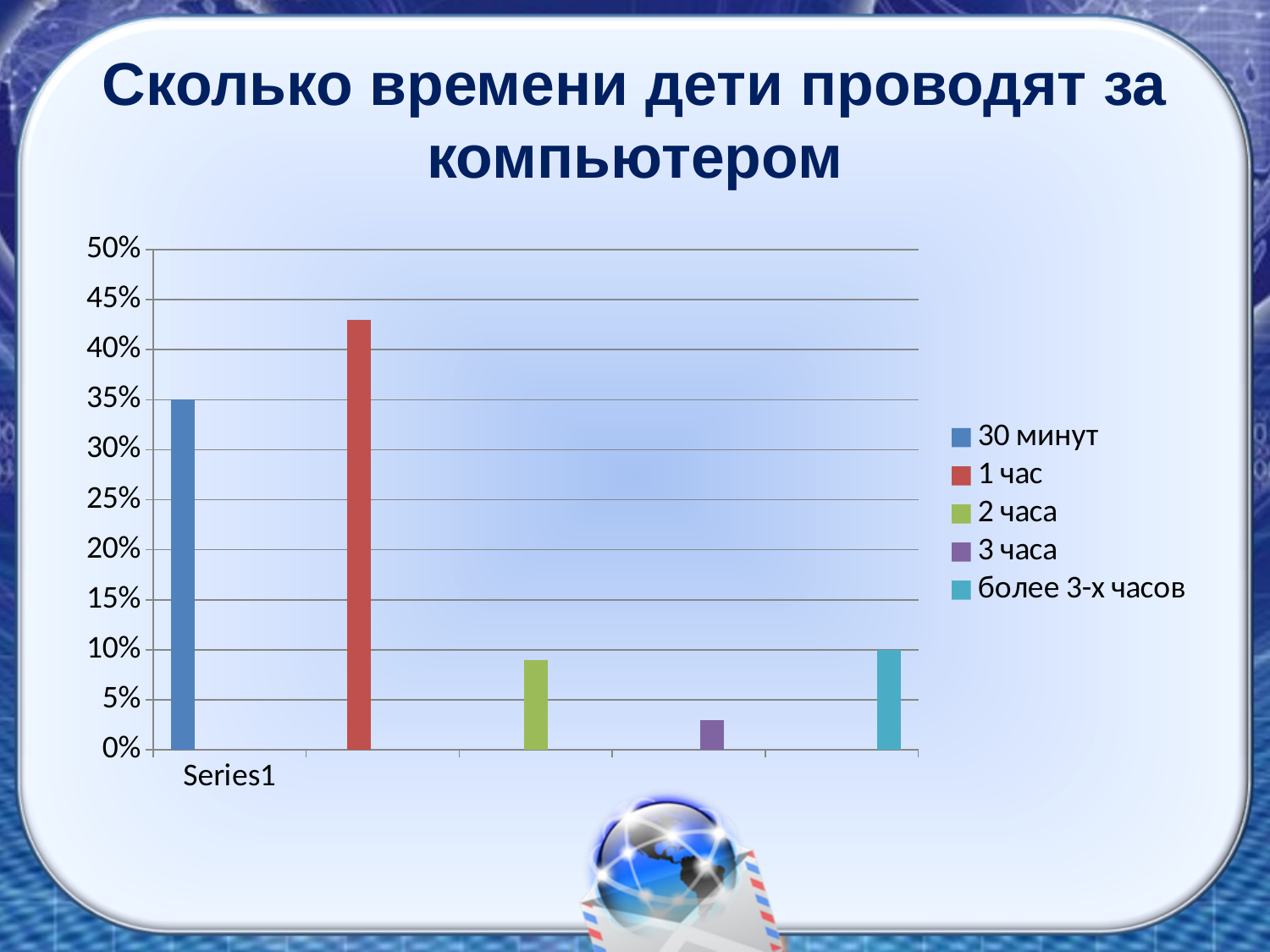
Which is larger, the value for 30 минут or the value for 1 час? 1 час Is the value for 3 часа greater or less than 5%? less Is the value for 30 минут greater or less than 30%? greater Which series has the lowest value? 3 часа How many series does the legend list? 5 Is the value for 1 час greater or less than 40%? greater What kind of chart is shown on the slide? bar chart What is the title of the chart? Сколько времени дети проводят за компьютером Which series has the highest value? 1 час What colour is the bar for 1 час? red Which is larger, the value for 2 часа or the value for более 3-х часов? более 3-х часов